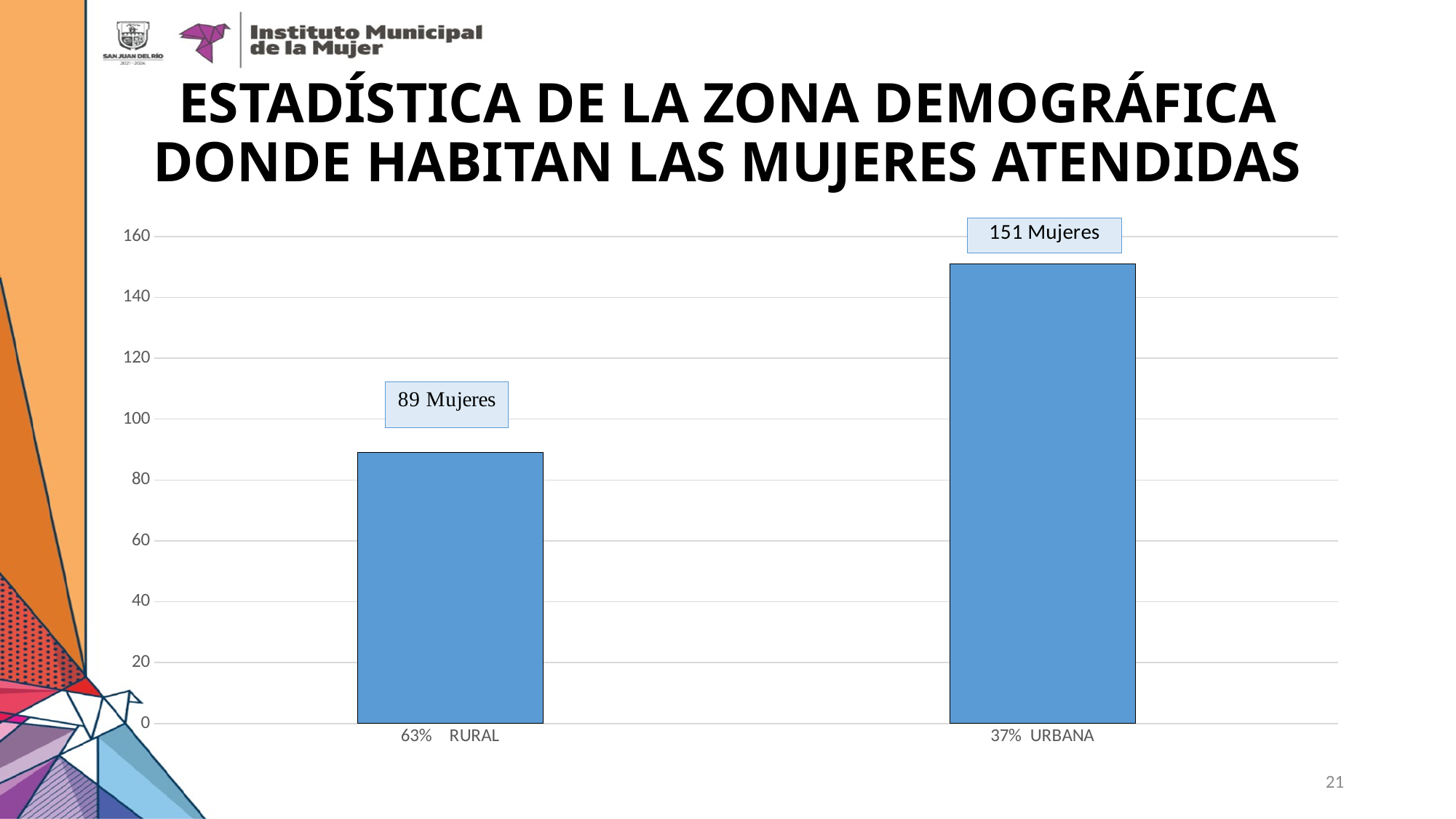
How many women are shown for the RURAL category? 89 Mujeres Which is larger, the value for RURAL or the value for URBANA? URBANA What is the total number of women across both categories? 240 What kind of chart is shown on the slide? bar chart Which category has the lowest number of women? RURAL How many women are shown for the URBANA category? 151 Mujeres Which category has the highest number of women? URBANA Is the value for URBANA greater or less than 140? greater What percentage label is shown next to the RURAL category on the x axis? 63% What is the difference between the number of women in URBANA and RURAL? 62 How many categories are shown in the chart? 2 Is the value for RURAL greater or less than 100? less